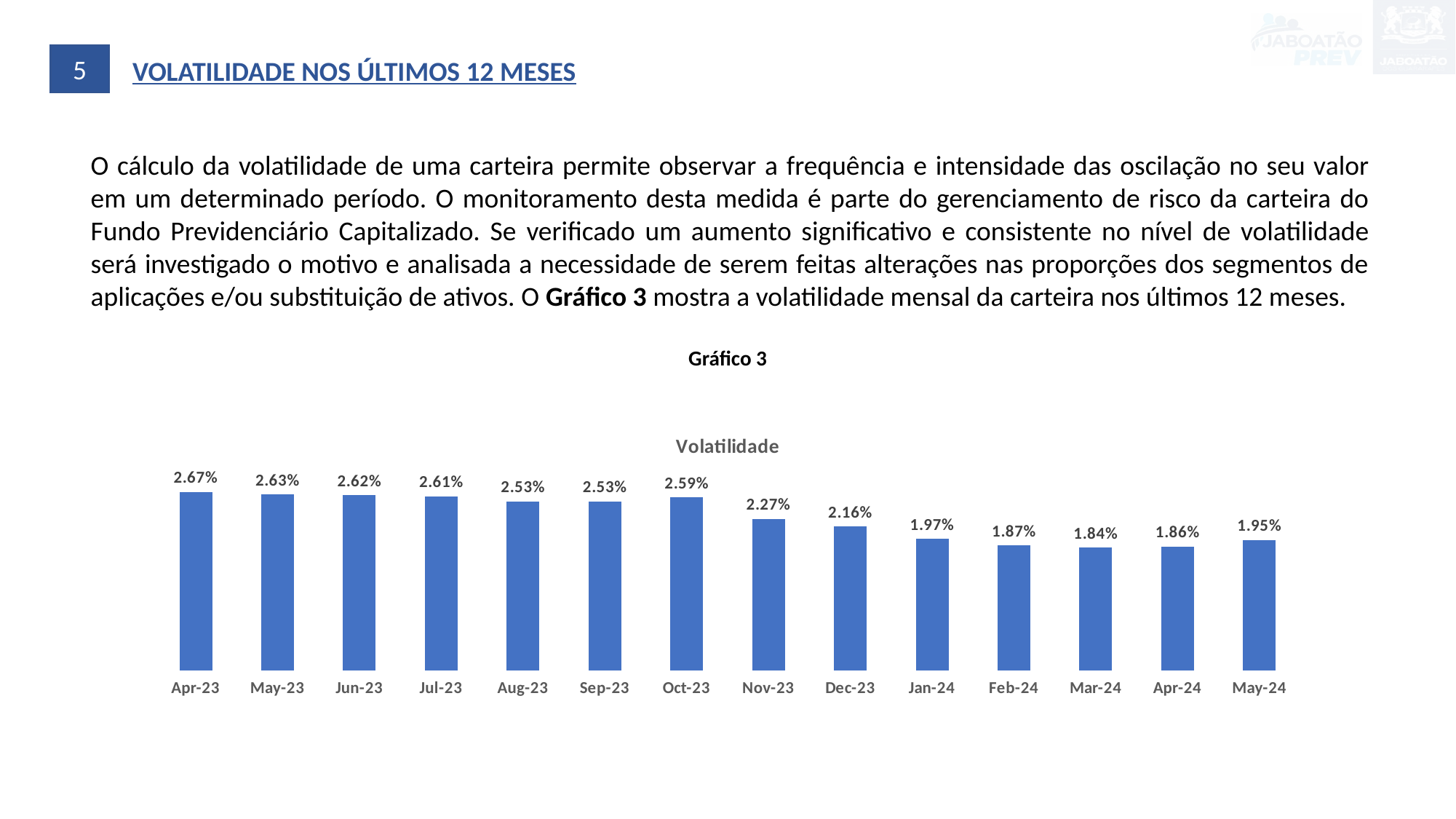
What is the volatility value for Mar-24? 1.84% What kind of chart is shown? Bar chart What is the difference between the volatility in Apr-23 and May-24? 0.72% What is the difference between the volatility in Nov-23 and Dec-23? 0.11% How many months are shown on the chart? 14 Do the volatility values generally rise or fall from Apr-23 to Mar-24? Fall Which month has the highest volatility? Apr-23 Which is larger, the volatility in Jan-24 or in Feb-24? Jan-24 What is the volatility value for Oct-23? 2.59% Which month has the lowest volatility? Mar-24 What is the title of the chart? Volatilidade What is the volatility value for Nov-23? 2.27%